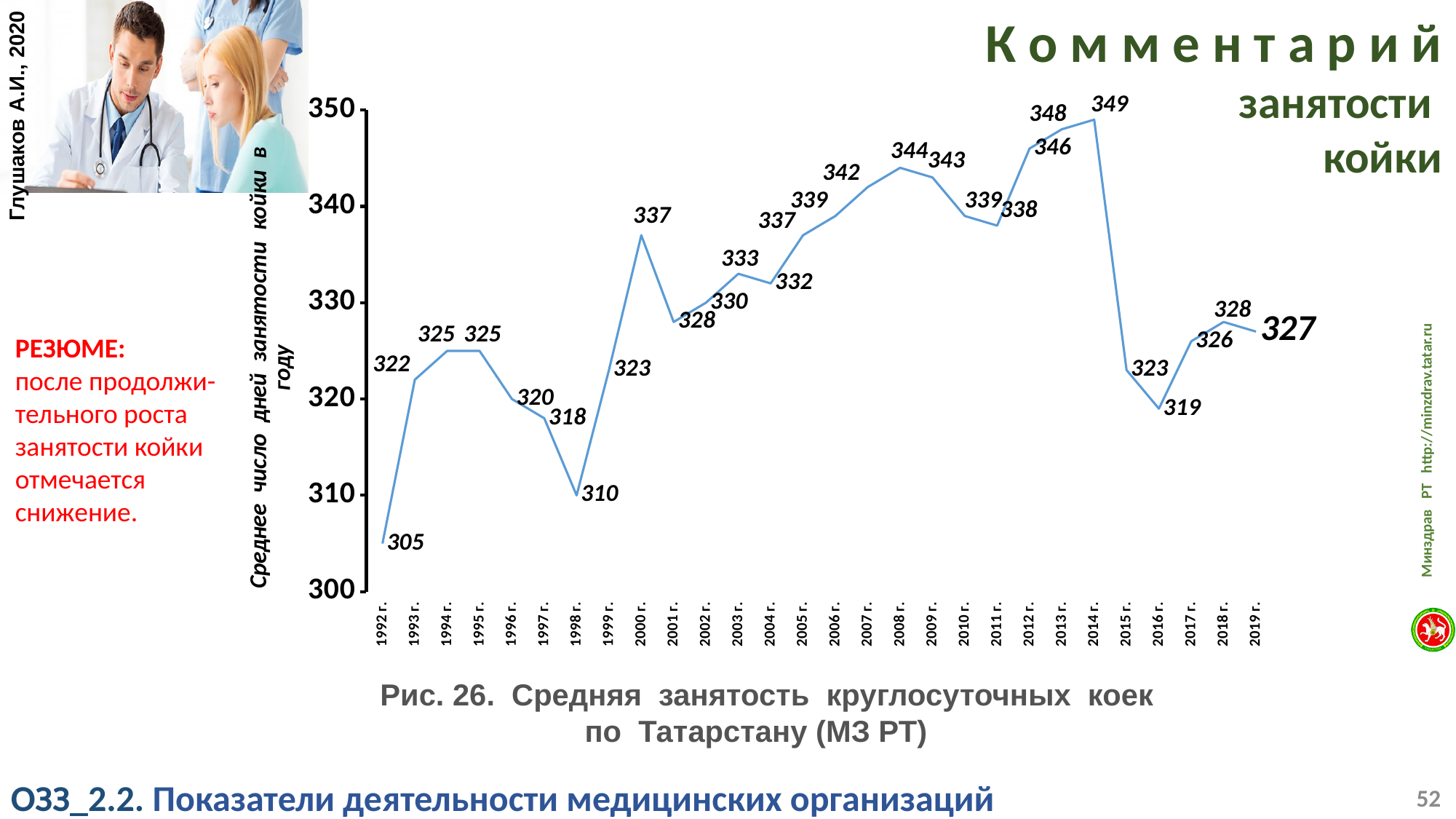
What is the difference between the values for 2014 and 2015? 26 Do the values rise or fall from 2014 to 2016? fall Which year has the highest value on the chart? 2014 What is the average bed occupancy value for 2014? 349 What is the value shown for 2019? 327 What is the value shown for 1992? 305 What is the figure number and title of the chart? Рис. 26. Средняя занятость круглосуточных коек по Татарстану (МЗ РТ) Which is larger, the value for 2000 or the value for 2001? 2000 What type of chart is shown on the slide? line chart What is the value shown for 2016? 319 Which year has the lowest value on the chart? 1992 How many years (data points) are plotted on the chart? 28